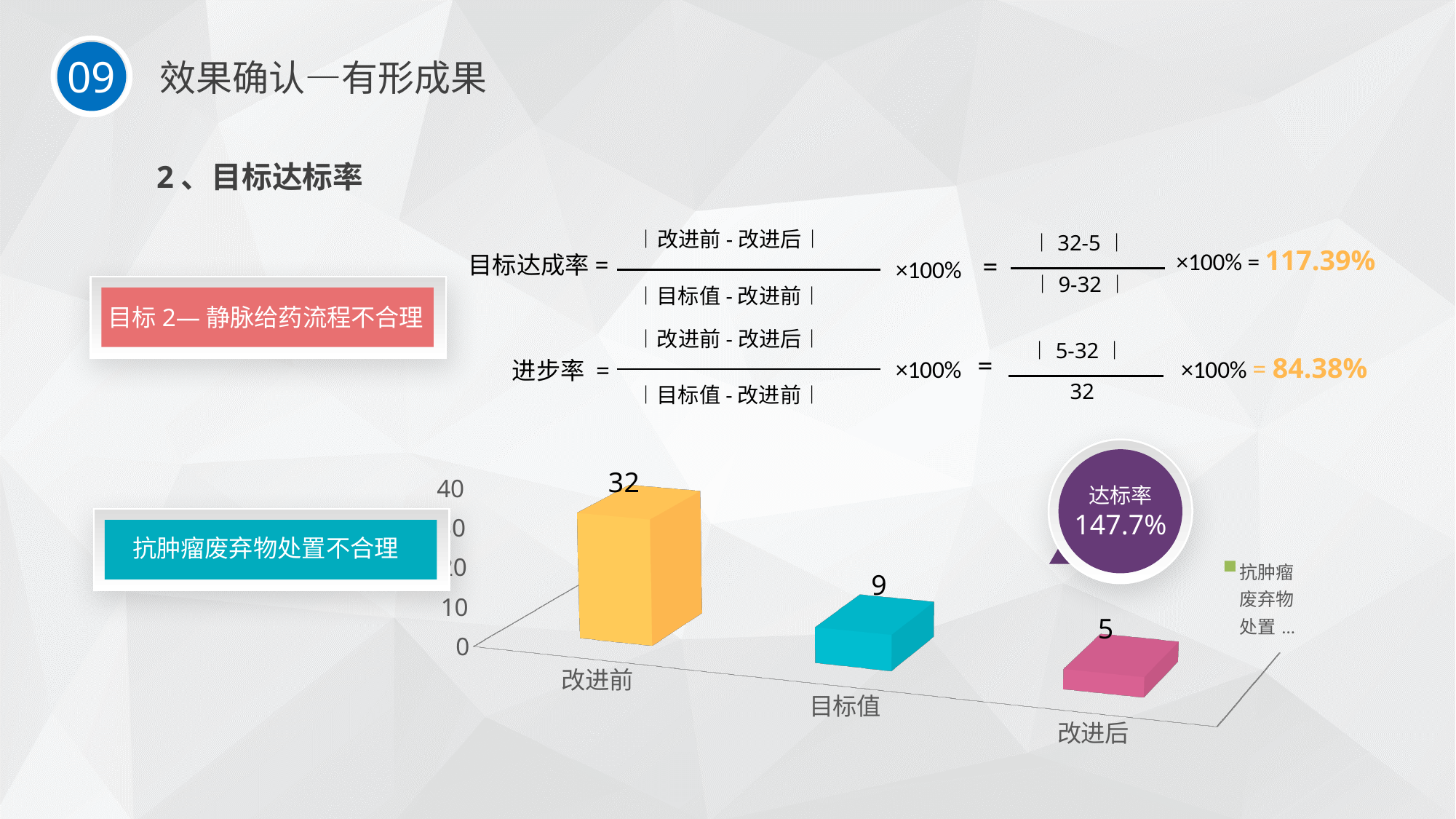
Which is larger, the value for 目标值 or the value for 改进后? 目标值 Which category has the lowest value in the chart? 改进后 What is the value for 目标值 in the chart? 9 What is the value for 改进后 in the chart? 5 Do the values rise or fall from 改进前 to 改进后 along the x axis? fall What is the difference between the values for 改进前 and 改进后? 27 What is the difference between the values for 目标值 and 改进后? 4 What is the value for 改进前 in the chart? 32 How many categories are shown on the x axis of the chart? 3 What kind of chart is shown on the slide? bar chart Is the value for 改进前 greater or less than 20? greater Which category has the highest value in the chart? 改进前